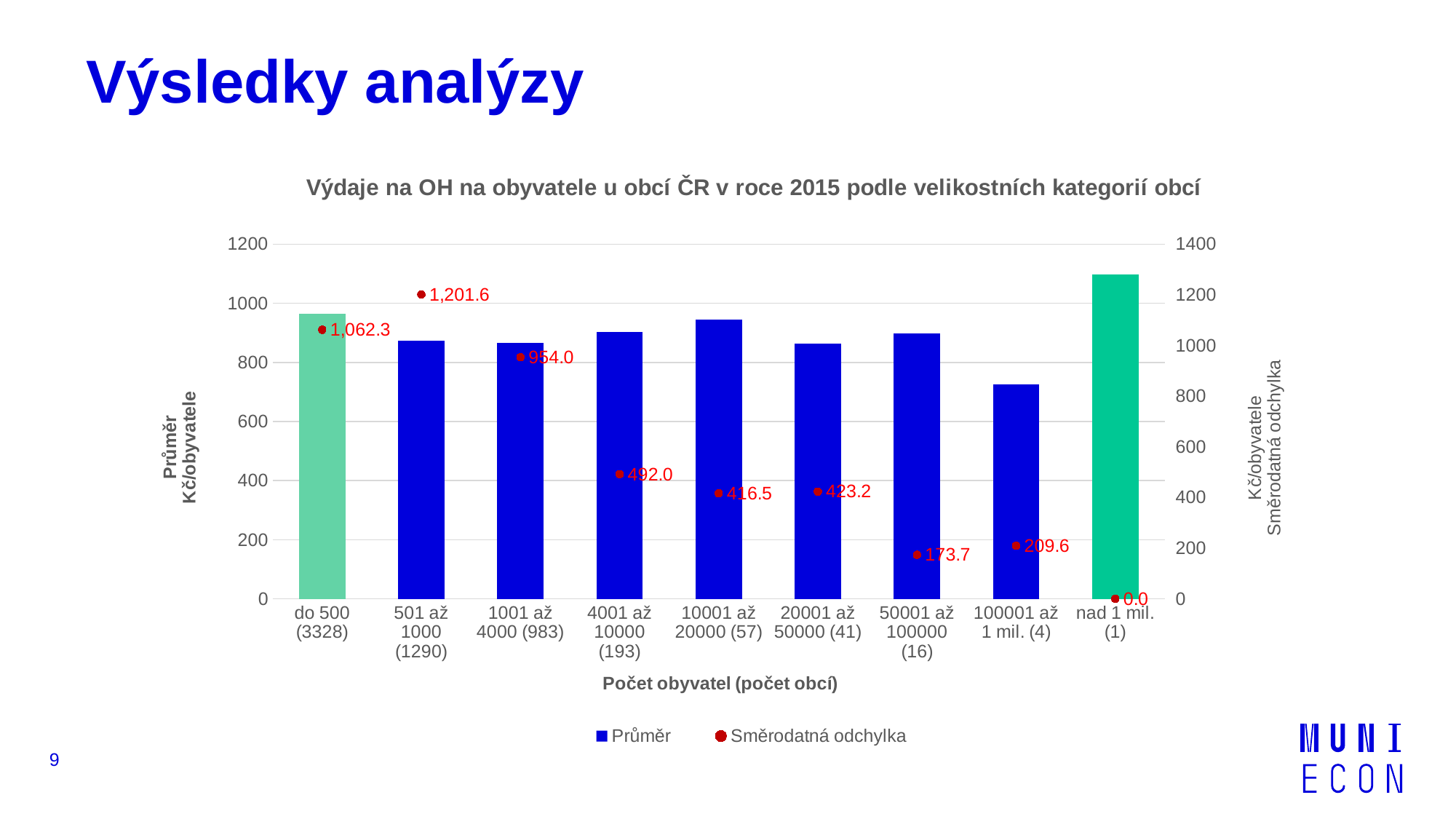
Is the Průměr bar for '100001 až 1 mil. (4)' greater or less than 800? less Which category has the highest Směrodatná odchylka value? 501 až 1000 (1290) How many series does the legend list? 2 Which category has the tallest Průměr bar? nad 1 mil. (1) What is the difference between the Směrodatná odchylka values for '4001 až 10000 (193)' and '10001 až 20000 (57)'? 75.5 What is the Směrodatná odchylka value for the category '501 až 1000 (1290)'? 1,201.6 Which category has the lowest Směrodatná odchylka value? nad 1 mil. (1) Is the Průměr bar for 'nad 1 mil. (1)' greater or less than 1000? greater Which category has the shortest Průměr bar? 100001 až 1 mil. (4) What is the Směrodatná odchylka value for the category '50001 až 100000 (16)'? 173.7 What is the Směrodatná odchylka value for the category 'do 500 (3328)'? 1,062.3 What is the difference between the Směrodatná odchylka values for '501 až 1000 (1290)' and 'do 500 (3328)'? 139.3